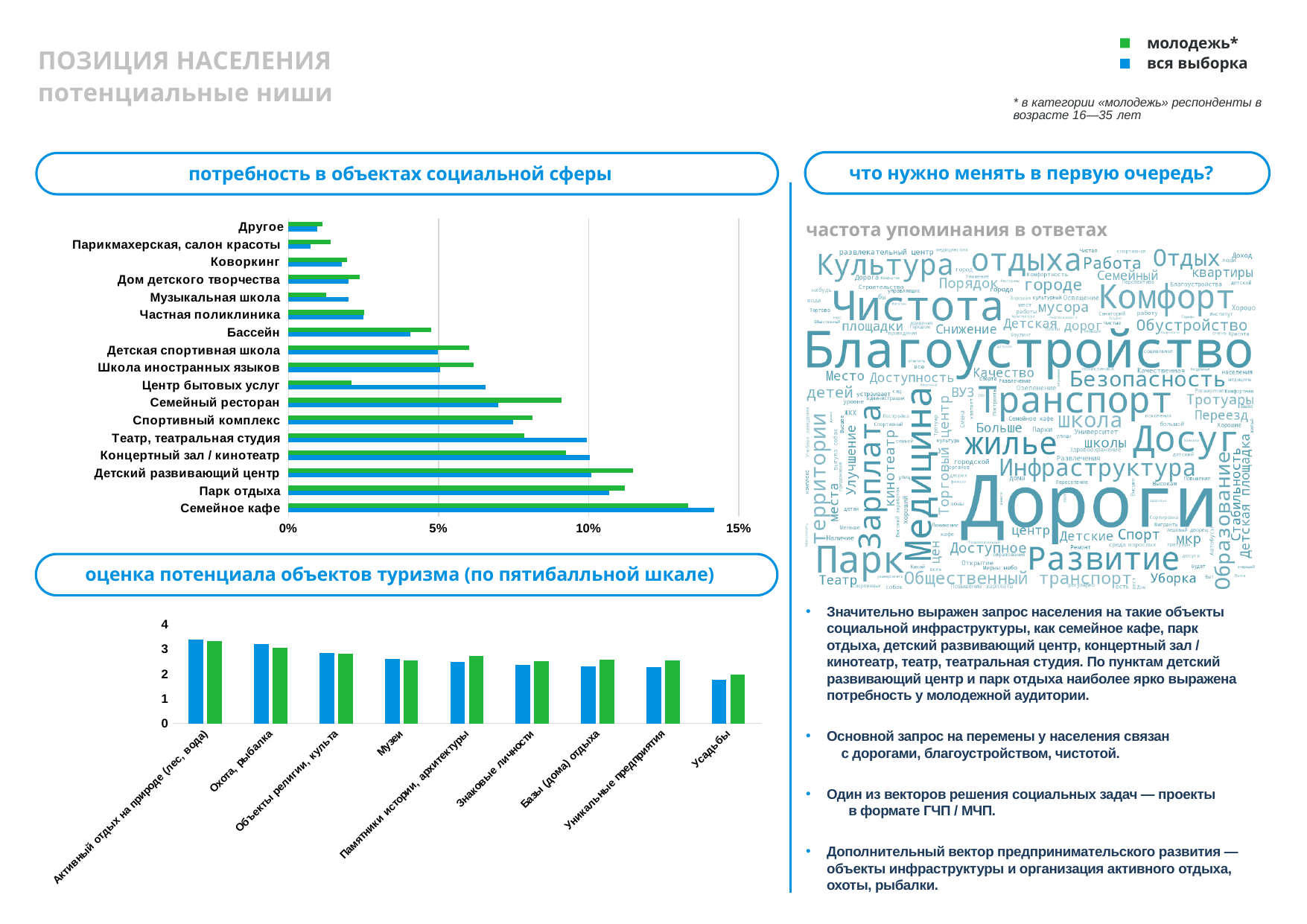
What kind of chart is the chart titled «потребность в объектах социальной сферы»? bar chart How many series does the legend list for the charts on the slide? 2 In the chart «потребность в объектах социальной сферы», is the value for «Центр бытовых услуг» in the «молодежь» series greater or less than 5%? less In the chart «оценка потенциала объектов туризма (по пятибалльной шкале)», which category has the highest value for «вся выборка»? Активный отдых на природе (лес, вода) In the chart «потребность в объектах социальной сферы», for «Семейный ресторан», which series has the larger value: «молодежь» or «вся выборка»? молодежь In the chart «оценка потенциала объектов туризма (по пятибалльной шкале)», is the value for «Усадьбы» in the «вся выборка» series greater or less than 2? less Which colour represents the «молодежь» series in the charts on the slide? green In the chart «потребность в объектах социальной сферы», for «Центр бытовых услуг», which series has the larger value: «молодежь» or «вся выборка»? вся выборка In the chart «потребность в объектах социальной сферы», which category has the highest value for «вся выборка»? Семейное кафе How many categories are shown in the chart «оценка потенциала объектов туризма (по пятибалльной шкале)»? 9 How many categories are shown in the chart «потребность в объектах социальной сферы»? 17 In the chart «потребность в объектах социальной сферы», is the value for «Семейное кафе» in the «вся выборка» series greater or less than 10%? greater